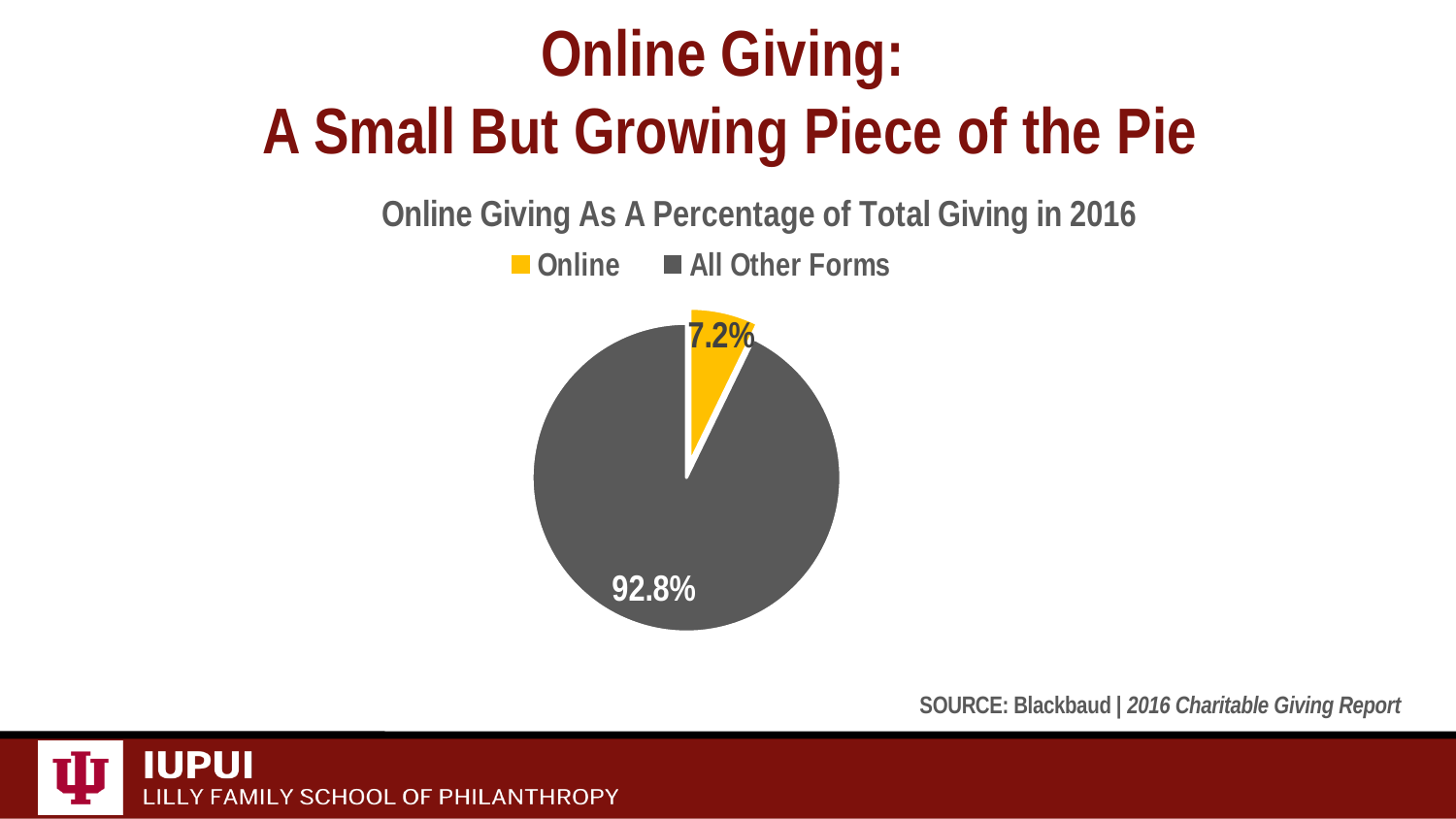
How many entries does the legend list? 2 What percentage of total giving in 2016 was All Other Forms? 92.8% What is the difference in percentage points between All Other Forms and Online? 85.6 How many slices does the pie chart have? 2 Which slice of the pie is the smallest? Online Which is larger, the Online slice or the All Other Forms slice? All Other Forms What percentage of total giving in 2016 was Online? 7.2% Which slice of the pie is the largest? All Other Forms What is the chart's title? Online Giving As A Percentage of Total Giving in 2016 What share of the pie does the Online slice represent? 7.2% What colour is the Online slice? yellow What kind of chart is shown on the slide? pie chart